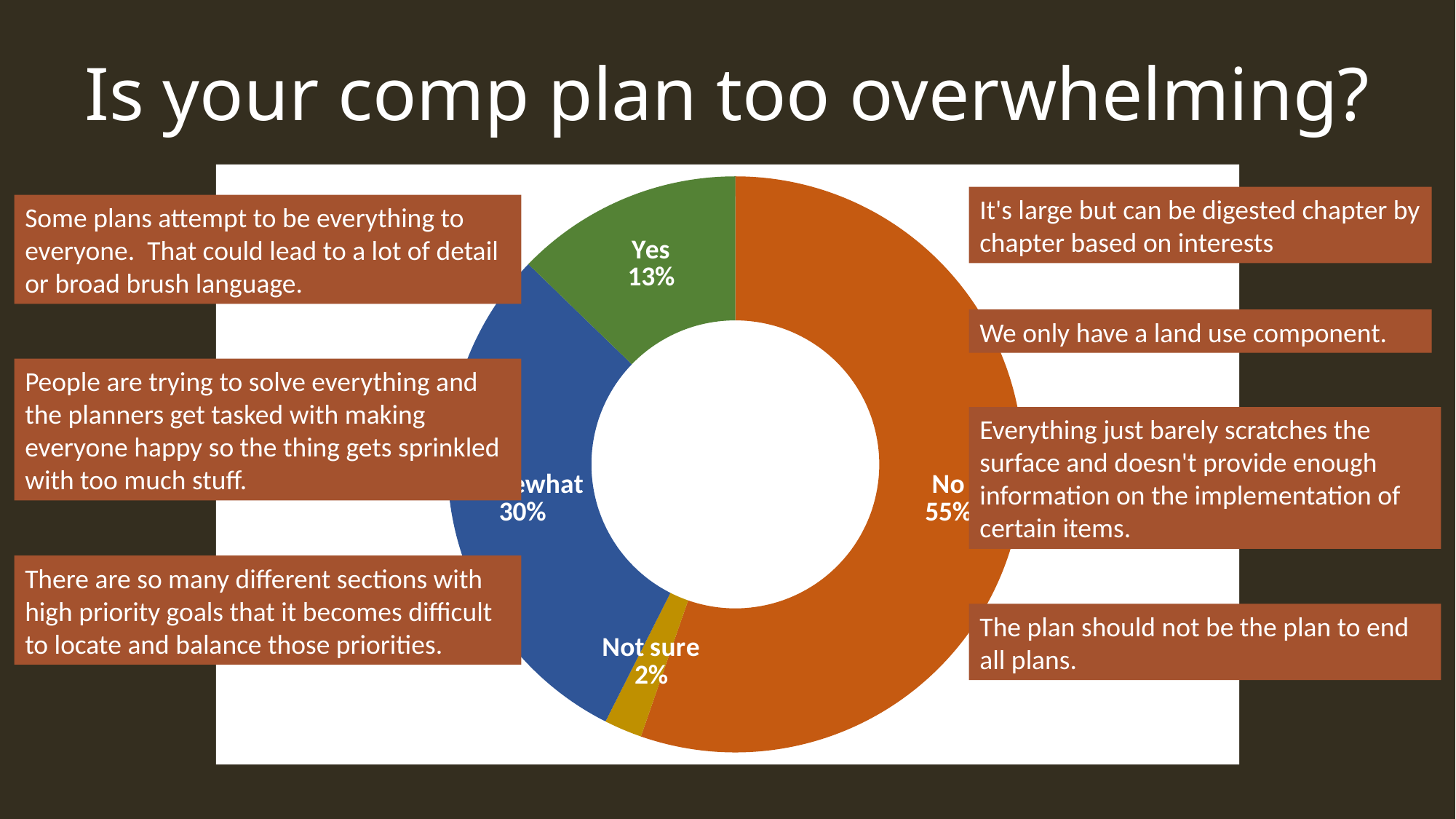
What is the difference in percentage points between the "Somewhat" and "Yes" responses? 17 Which is larger, the share for "Yes" or the share for "Somewhat"? Somewhat Which response has the largest share of the chart? No What kind of chart is shown on the slide? Doughnut (pie) chart What percentage of respondents answered "No"? 55% What percentage of respondents answered "Not sure"? 2% What percentage of respondents answered "Somewhat"? 30% How many response categories are shown in the chart? 4 What percentage of respondents answered "Yes"? 13% Which response has the smallest share of the chart? Not sure What is the difference in percentage points between the "No" and "Yes" responses? 42 What colour is the "No" slice of the chart? Orange